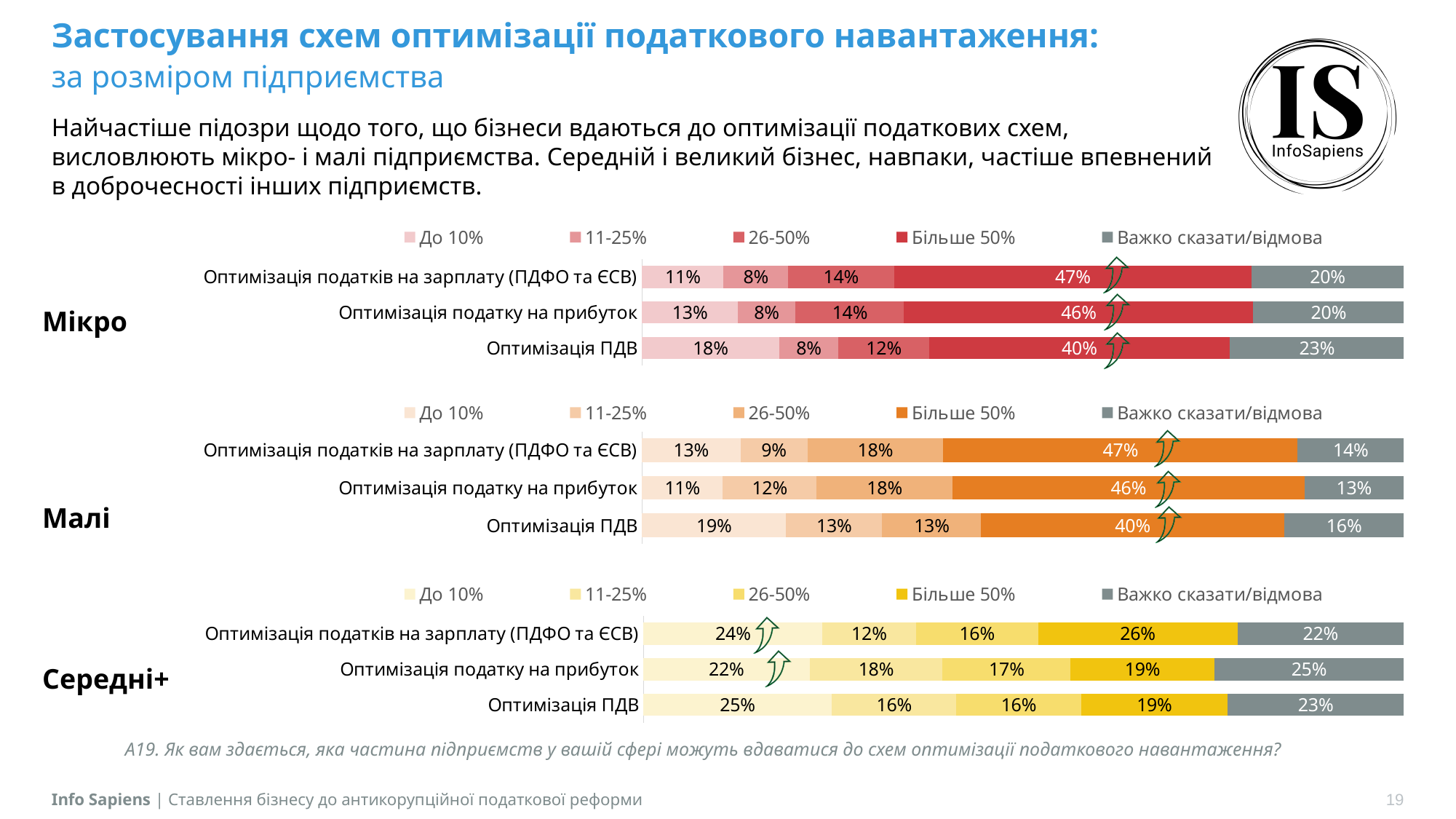
In the Мікро chart, which has the larger 'До 10%' value: 'Оптимізація ПДВ' or 'Оптимізація податків на зарплату (ПДФО та ЄСВ)'? Оптимізація ПДВ In the Середні+ chart, what is the difference between the 'Більше 50%' values for 'Оптимізація податків на зарплату (ПДФО та ЄСВ)' and 'Оптимізація ПДВ'? 7 percentage points What type of chart is used for the Мікро group? Stacked bar chart In the Малі chart, which category has the lowest 'Важко сказати/відмова' value? Оптимізація податку на прибуток In the Середні+ chart, what is the value of the 'До 10%' segment for 'Оптимізація ПДВ'? 25% How many categories (bars) are shown in the Малі chart? 3 In the Малі chart, what is the value of the 'Важко сказати/відмова' segment for 'Оптимізація податку на прибуток'? 13% In the Середні+ chart, which category has the highest 'Важко сказати/відмова' value? Оптимізація податку на прибуток In the Мікро chart, what is the total of all segments for 'Оптимізація податків на зарплату (ПДФО та ЄСВ)'? 100% In the Мікро chart, what is the value of the 'Більше 50%' segment for 'Оптимізація ПДВ'? 40% What is the last legend entry in the Середні+ chart? Важко сказати/відмова How many series does the legend of the Середні+ chart list? 5